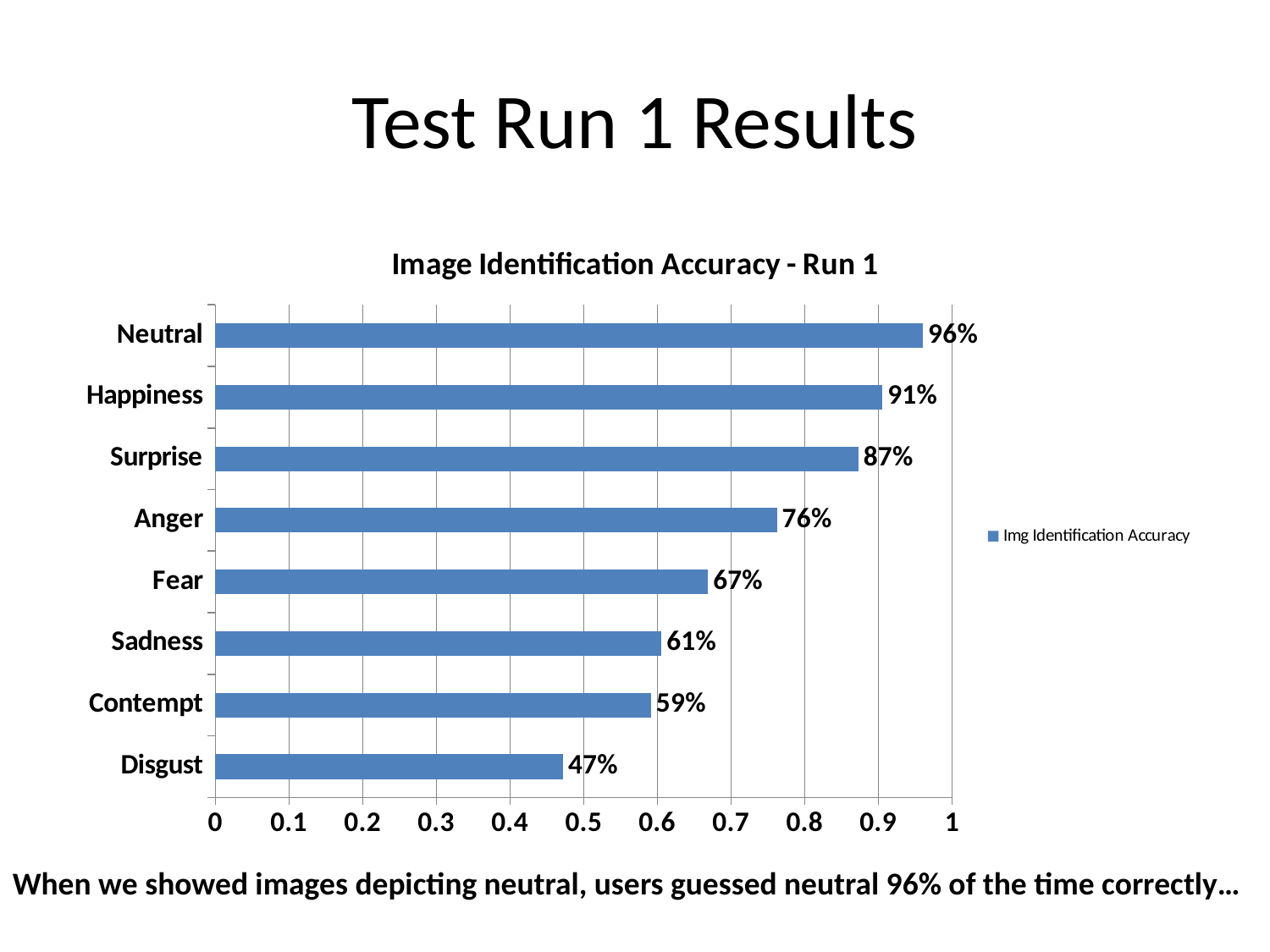
Which category has the highest image identification accuracy? Neutral Is the value for Anger greater or less than 0.7? greater Which has a higher accuracy, Surprise or Sadness? Surprise What is the image identification accuracy for Fear? 67% What is the title of the chart? Image Identification Accuracy - Run 1 Which category has the lowest image identification accuracy? Disgust How many categories are shown in the chart? 8 What is the difference between the accuracy for Happiness and the accuracy for Anger? 15% How many series does the legend list? 1 What kind of chart is shown on the slide? Bar chart What is the image identification accuracy for Neutral? 96% What is the image identification accuracy for Contempt? 59%